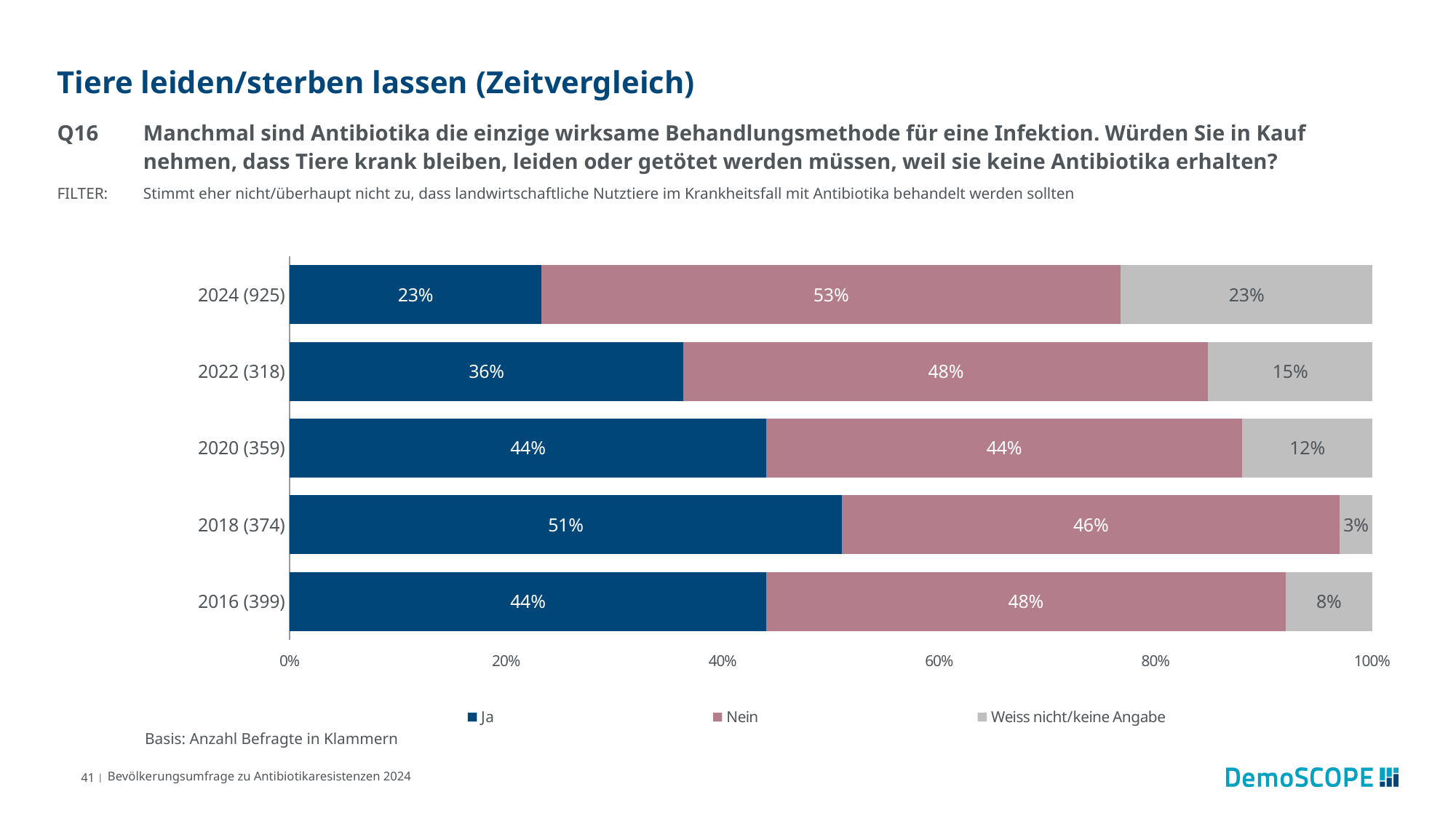
What kind of chart is shown on the slide? Stacked bar chart How many series does the legend list? 3 Which is larger: the "Nein" value for 2024 (925) or for 2020 (359)? 2024 (925) What is the value for "Nein" in 2022 (318)? 48% Which colour represents "Nein" in the chart? Pink/mauve What is the value for "Weiss nicht/keine Angabe" in 2018 (374)? 3% What is the value for "Ja" in 2024 (925)? 23% Does the "Ja" value rise or fall from 2018 (374) to 2024 (925)? Fall How many years (categories) are shown in the chart? 5 What is the difference between the "Ja" values for 2018 (374) and 2024 (925)? 28 percentage points Which year has the lowest value for "Weiss nicht/keine Angabe"? 2018 (374) Which year has the highest value for "Ja"? 2018 (374)